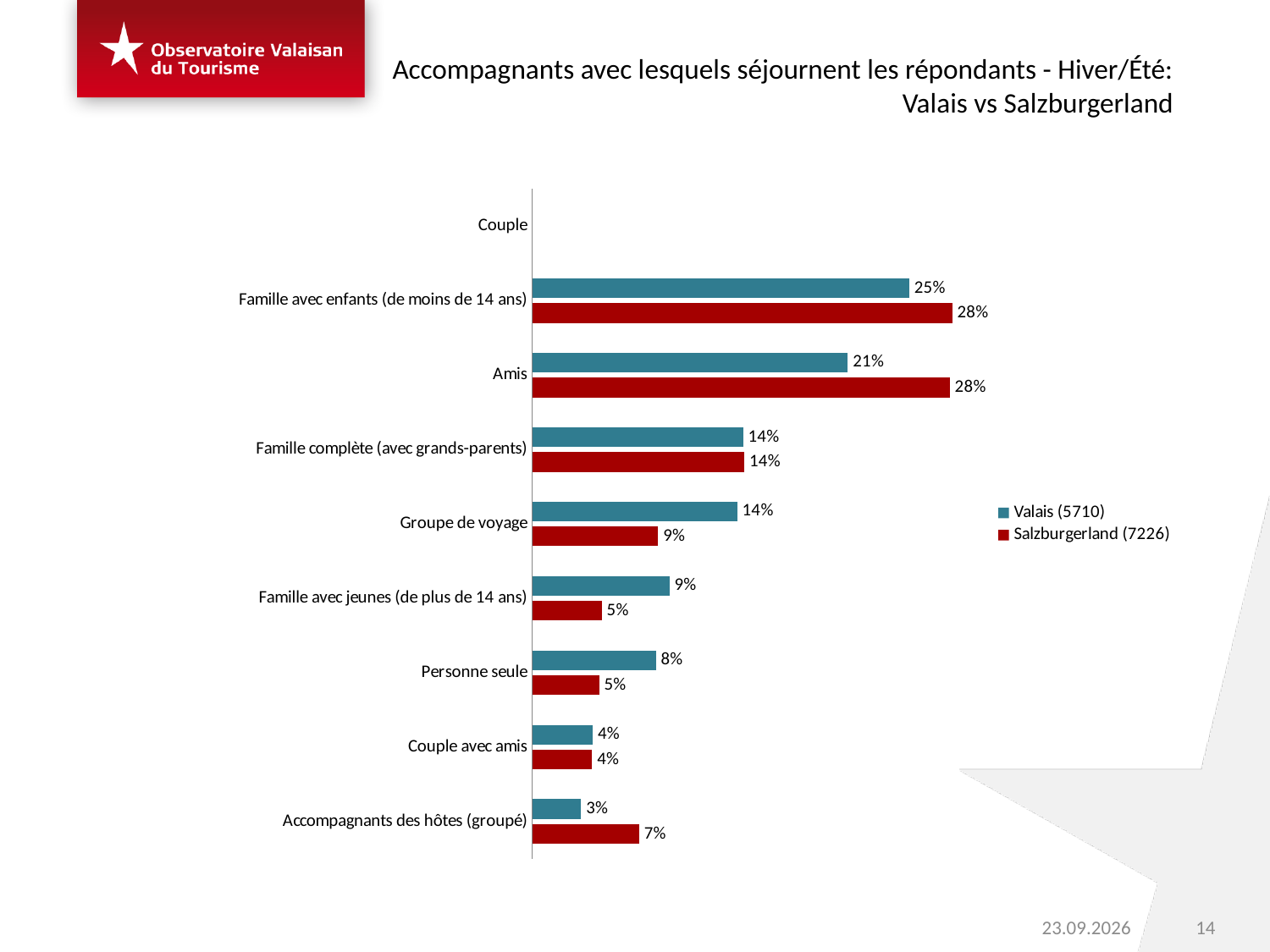
Which category has the lowest Valais (5710) value? Accompagnants des hôtes (groupé) What is the difference between the Salzburgerland (7226) and Valais (5710) values for Amis? 7 percentage points What is the Valais (5710) value for Personne seule? 8% For Accompagnants des hôtes (groupé), which series has the larger value, Valais (5710) or Salzburgerland (7226)? Salzburgerland (7226) Which category has the highest Valais (5710) value? Famille avec enfants (de moins de 14 ans) What is the Salzburgerland (7226) value for Groupe de voyage? 9% What is the Salzburgerland (7226) value for Amis? 28% For Famille avec jeunes (de plus de 14 ans), which series has the larger value, Valais (5710) or Salzburgerland (7226)? Valais (5710) What colour are the Salzburgerland (7226) bars? Red How many series does the legend list? 2 What is the Valais (5710) value for Famille avec enfants (de moins de 14 ans)? 25% What kind of chart is shown on the slide? Bar chart